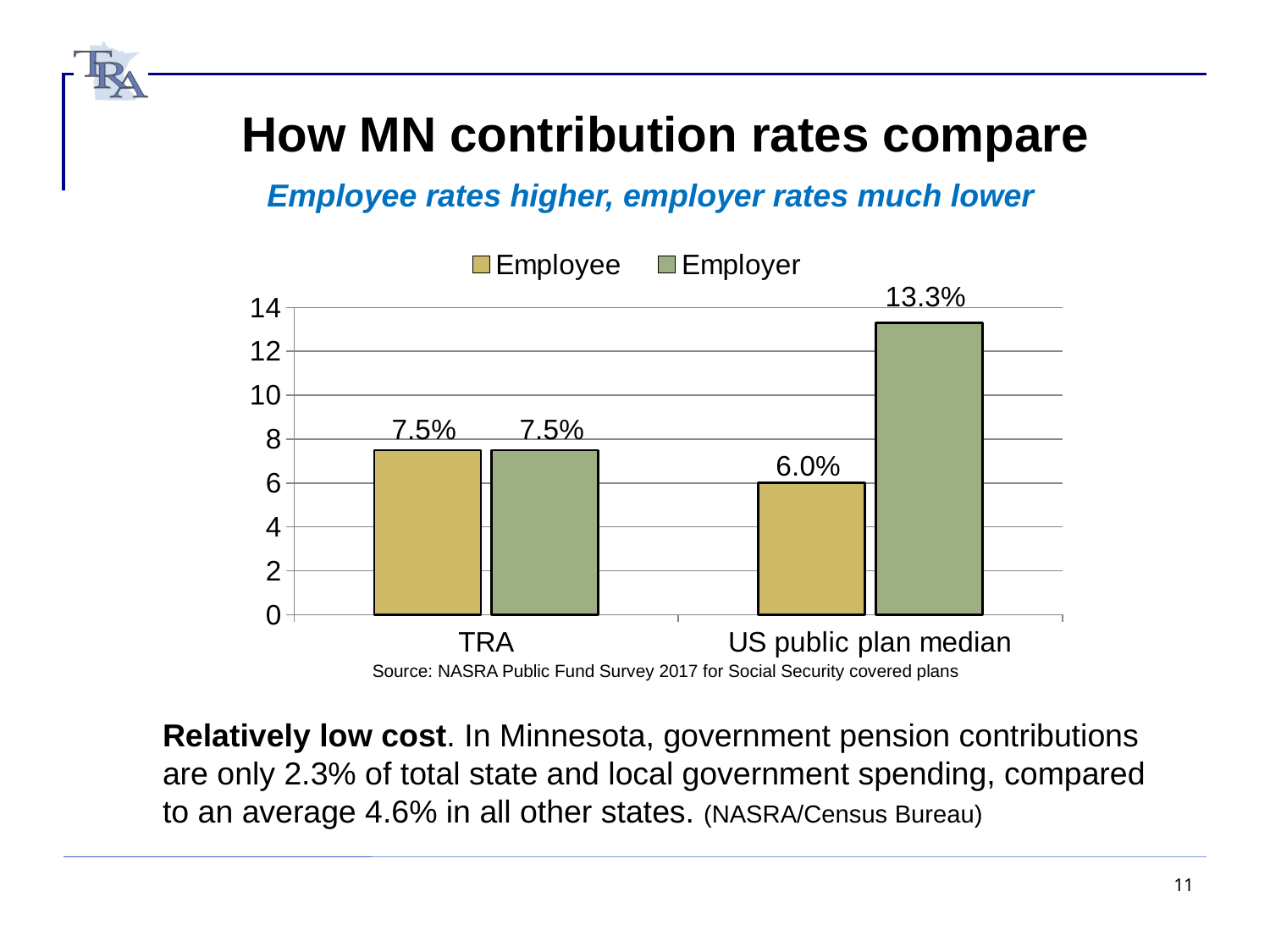
Which is larger: the Employee rate for TRA or the Employee rate for the US public plan median? TRA What is the Employer contribution rate for the US public plan median? 13.3% What kind of chart is shown on the slide? Bar chart How many series does the legend list? 2 What is the Employee contribution rate for TRA? 7.5% What is the difference between the Employer rate for the US public plan median and the Employer rate for TRA? 5.8% Which bar shows the highest value on the chart? US public plan median Employer How many categories are shown on the x axis? 2 Which bar shows the lowest value on the chart? US public plan median Employee Is the Employer value for the US public plan median greater or less than 12? greater What is the Employee contribution rate for the US public plan median? 6.0% What is the Employer contribution rate for TRA? 7.5%